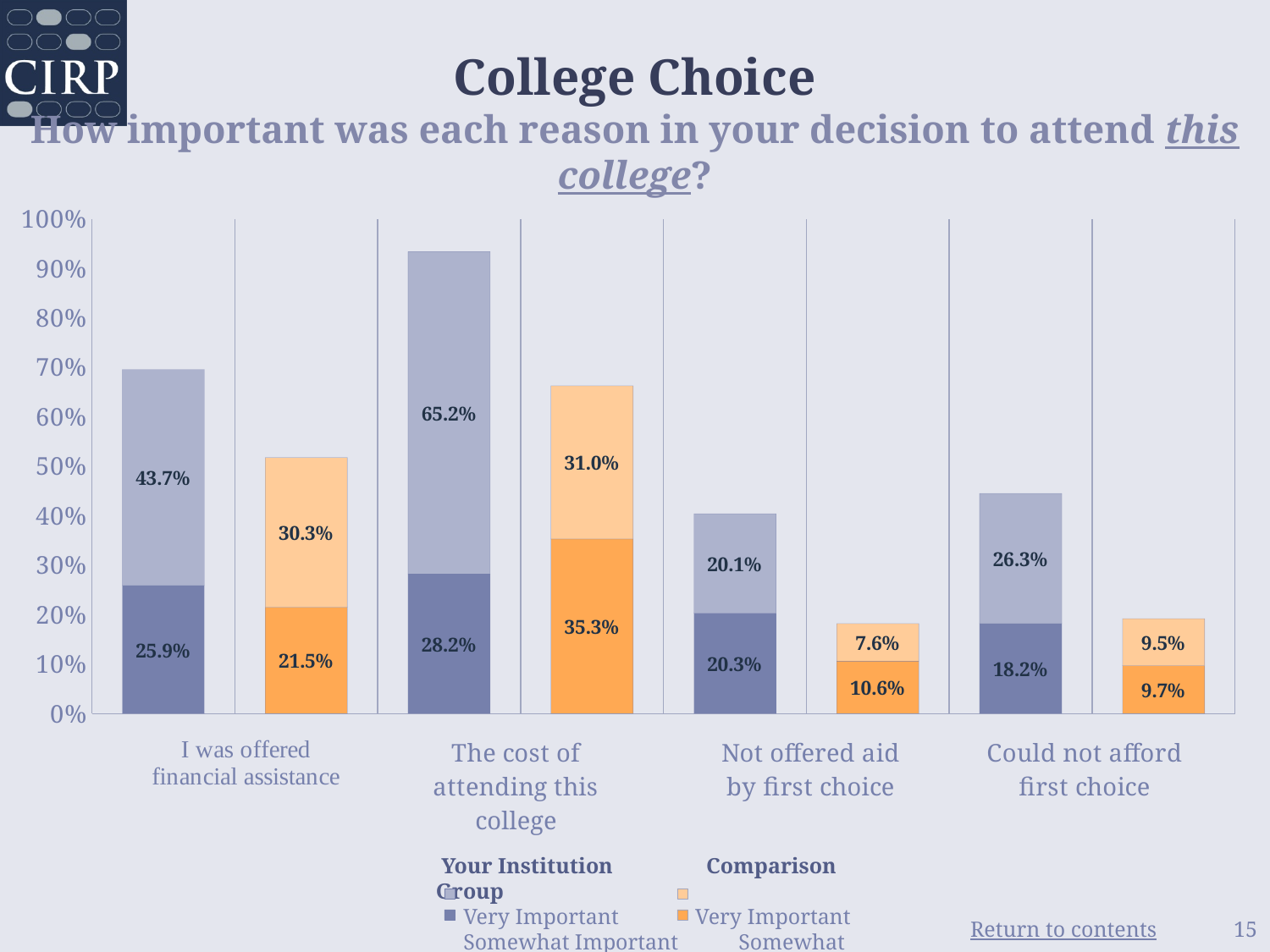
What type of chart is shown on the slide? stacked bar chart What percentage of the Comparison Group rated 'Not offered aid by first choice' as Very Important? 10.6% What is the total percentage (Very Important plus Somewhat Important) for the Comparison Group on 'Could not afford first choice'? 19.2% For 'The cost of attending this college', which group has the larger Very Important percentage, Your Institution or the Comparison Group? Comparison Group How many reasons (categories) are shown on the x axis? 4 What percentage of the Comparison Group rated 'I was offered financial assistance' as Somewhat Important? 30.3% What is the difference between Your Institution's and the Comparison Group's Very Important percentages for 'I was offered financial assistance'? 4.4% What percentage of Your Institution respondents rated 'The cost of attending this college' as Very Important? 28.2% Which reason has the lowest Very Important percentage for the Comparison Group? Could not afford first choice How many series does the legend list? 4 Which reason has the highest Very Important percentage for Your Institution? The cost of attending this college What is the total percentage (Very Important plus Somewhat Important) for Your Institution on 'The cost of attending this college'? 93.4%